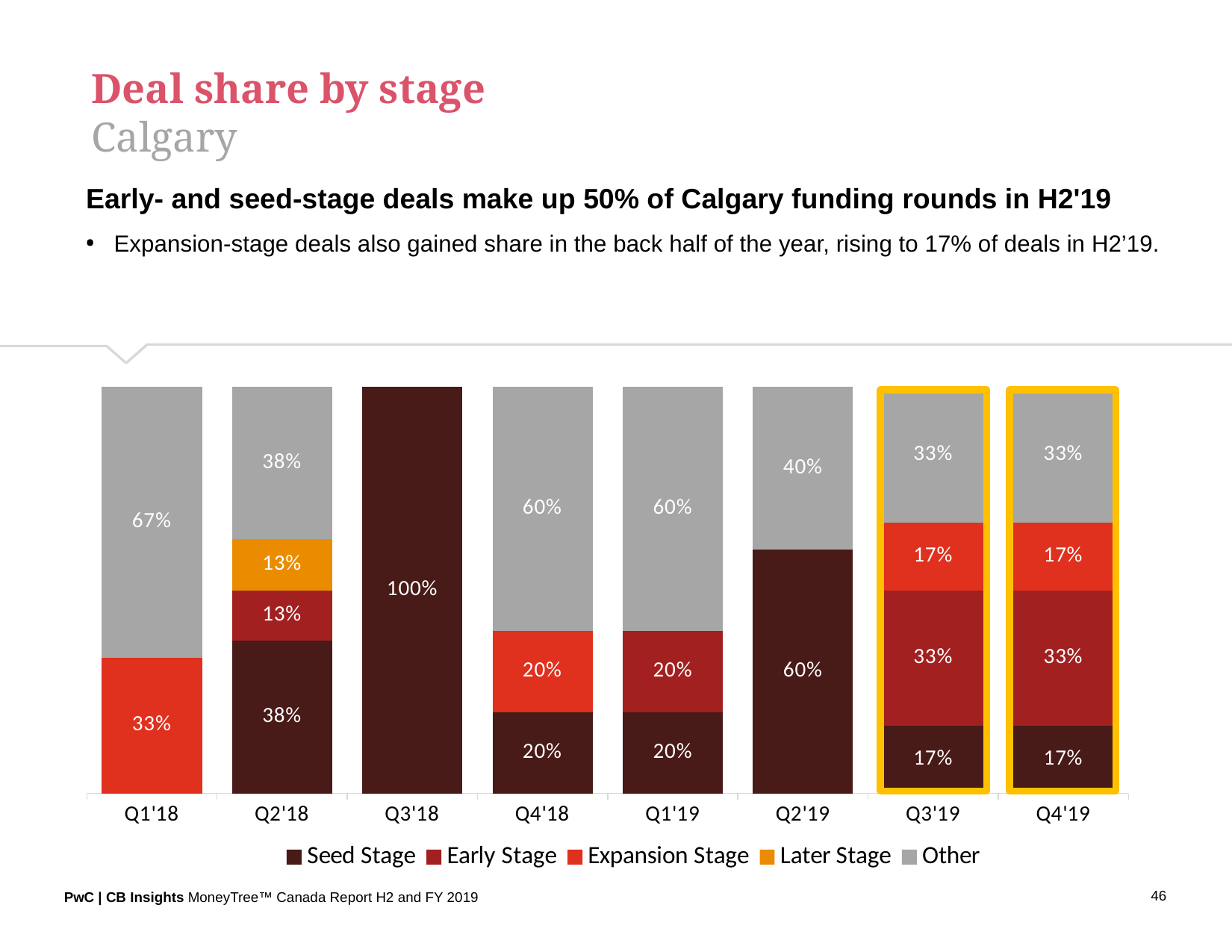
In which quarter is the Seed Stage share highest? Q3'18 Which is larger in Q3'19: the Early Stage share or the Seed Stage share? Early Stage What is the Other share of deals in Q1'18? 67% How many quarters are shown on the x axis of the chart? 8 What is the Early Stage share of deals in Q4'19? 33% What is the Later Stage share of deals in Q2'18? 13% What is the Seed Stage share of deals in Q3'18? 100% Which quarters are highlighted with a yellow outline on the chart? Q3'19 and Q4'19 What is the difference between the Other share in Q1'18 and the Other share in Q2'19? 27% What is the Expansion Stage share of deals in Q4'18? 20% What kind of chart is shown on the slide? Stacked bar chart How many series does the chart legend list? 5